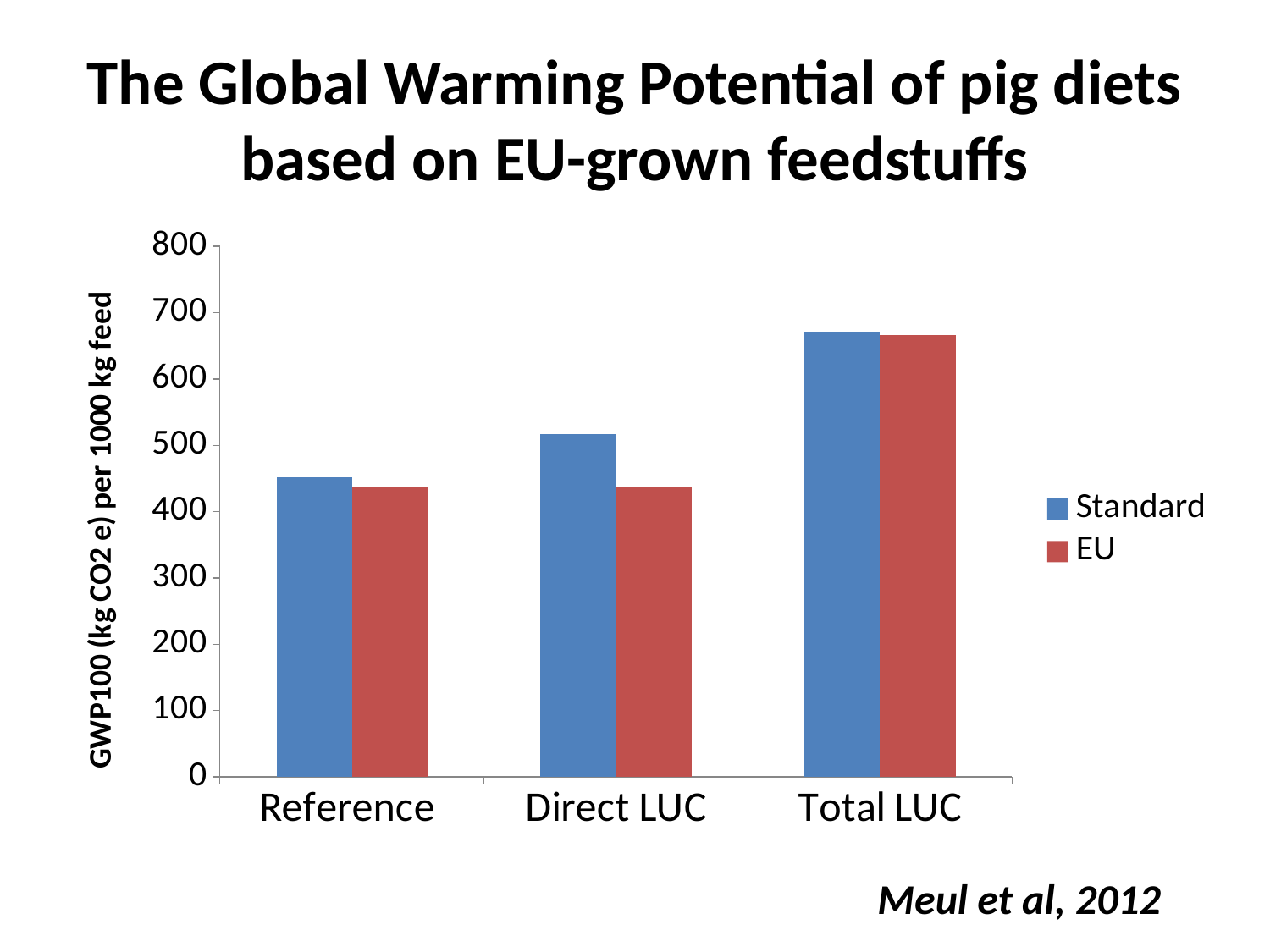
How many categories are shown on the x axis? 3 Is the Standard value for Reference greater or less than 400? greater Is the Standard value for Total LUC greater or less than 600? greater For Direct LUC, which series has the larger value, Standard or EU? Standard What are the two series named in the legend? Standard and EU Which category has the highest value for the EU series? Total LUC Is the EU value for Direct LUC greater or less than 500? less Which category has the lowest value for the Standard series? Reference What kind of chart is shown on the slide? bar chart Do the Standard values rise or fall from Reference to Total LUC? rise How many series does the legend list? 2 Which category has the highest value for the Standard series? Total LUC